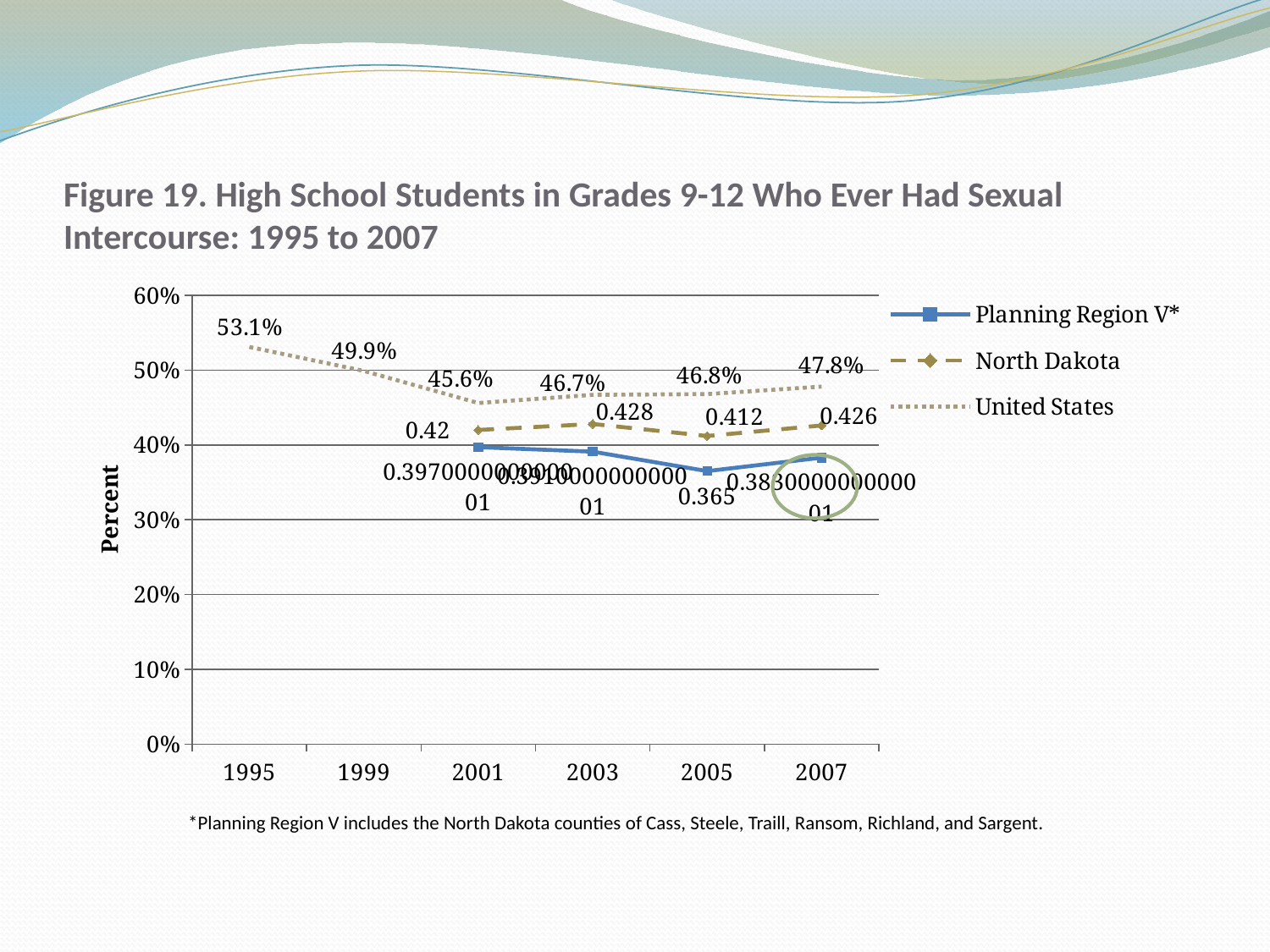
In which year is the United States value highest? 1995 What is the difference between the United States values for 1995 and 1999? 3.2% In 2007, which is larger: the North Dakota value or the United States value? United States What is the United States value for 1995? 53.1% In which year is the North Dakota value lowest? 2005 What is the North Dakota value for 2003? 0.428 What is the North Dakota value for 2005? 0.412 What kind of chart is shown on the slide? line chart What is the United States value for 2007? 47.8% What is the Planning Region V* value for 2005? 0.365 How many years are shown on the x axis? 6 How many series does the legend list? 3